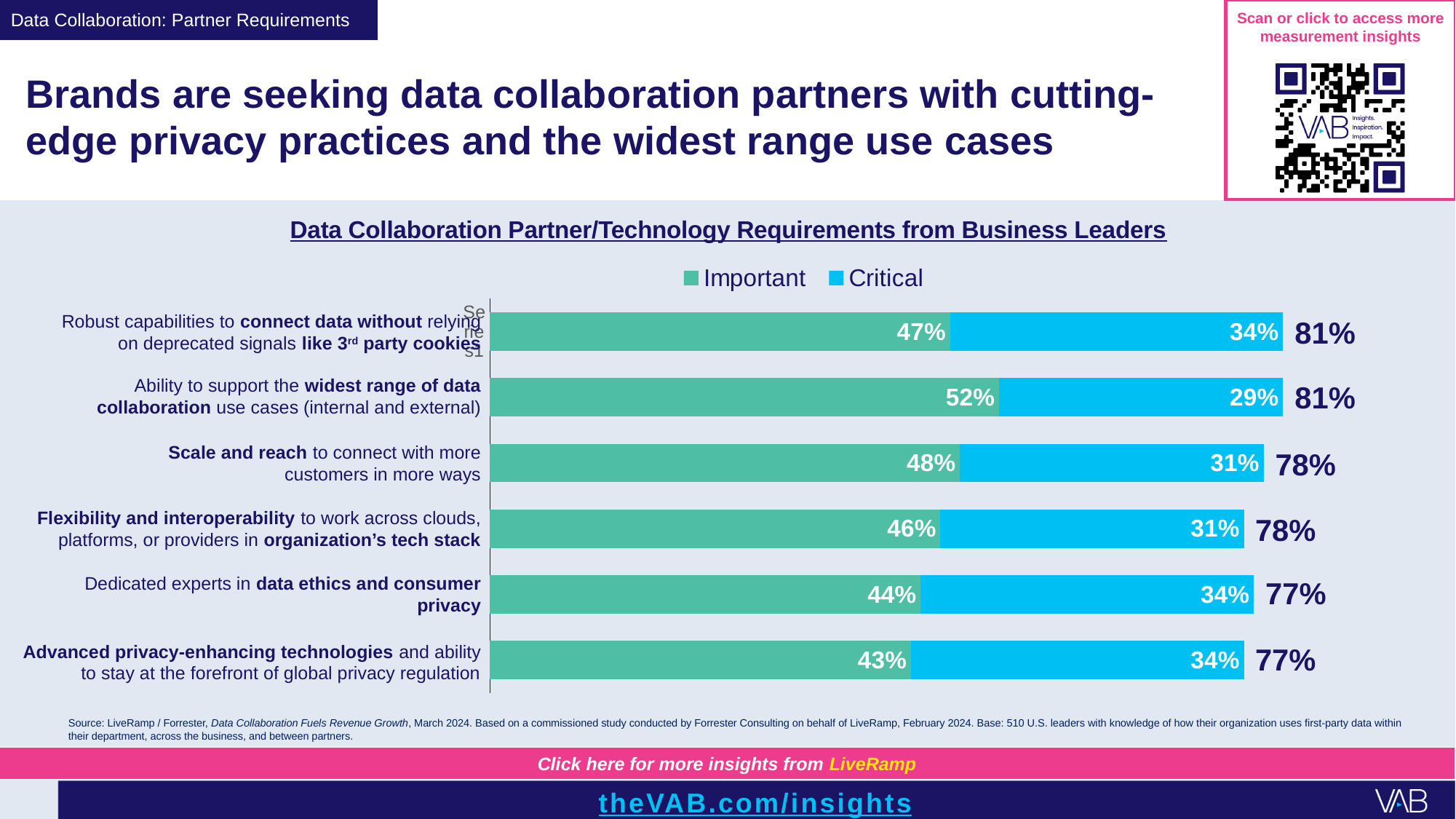
What kind of chart is shown on the slide? Stacked bar chart Which category has the highest 'Important' value? Ability to support the widest range of data collaboration use cases (internal and external) What is the combined total (Important plus Critical) for 'Flexibility and interoperability to work across clouds, platforms, or providers in organization's tech stack'? 77% How many categories are shown in the chart? 6 What is the 'Important' value for 'Advanced privacy-enhancing technologies and ability to stay at the forefront of global privacy regulation'? 43% Which category has the lowest 'Important' value? Advanced privacy-enhancing technologies and ability to stay at the forefront of global privacy regulation What is the difference between the 'Important' and 'Critical' values for 'Robust capabilities to connect data without relying on deprecated signals like 3rd party cookies'? 13% How many series does the legend list? 2 Which is larger: the 'Critical' value for 'Ability to support the widest range of data collaboration use cases' or the 'Critical' value for 'Dedicated experts in data ethics and consumer privacy'? Dedicated experts in data ethics and consumer privacy What is the 'Important' value for 'Ability to support the widest range of data collaboration use cases (internal and external)'? 52% What is the 'Critical' value for 'Dedicated experts in data ethics and consumer privacy'? 34% What is the 'Critical' value for 'Scale and reach to connect with more customers in more ways'? 31%